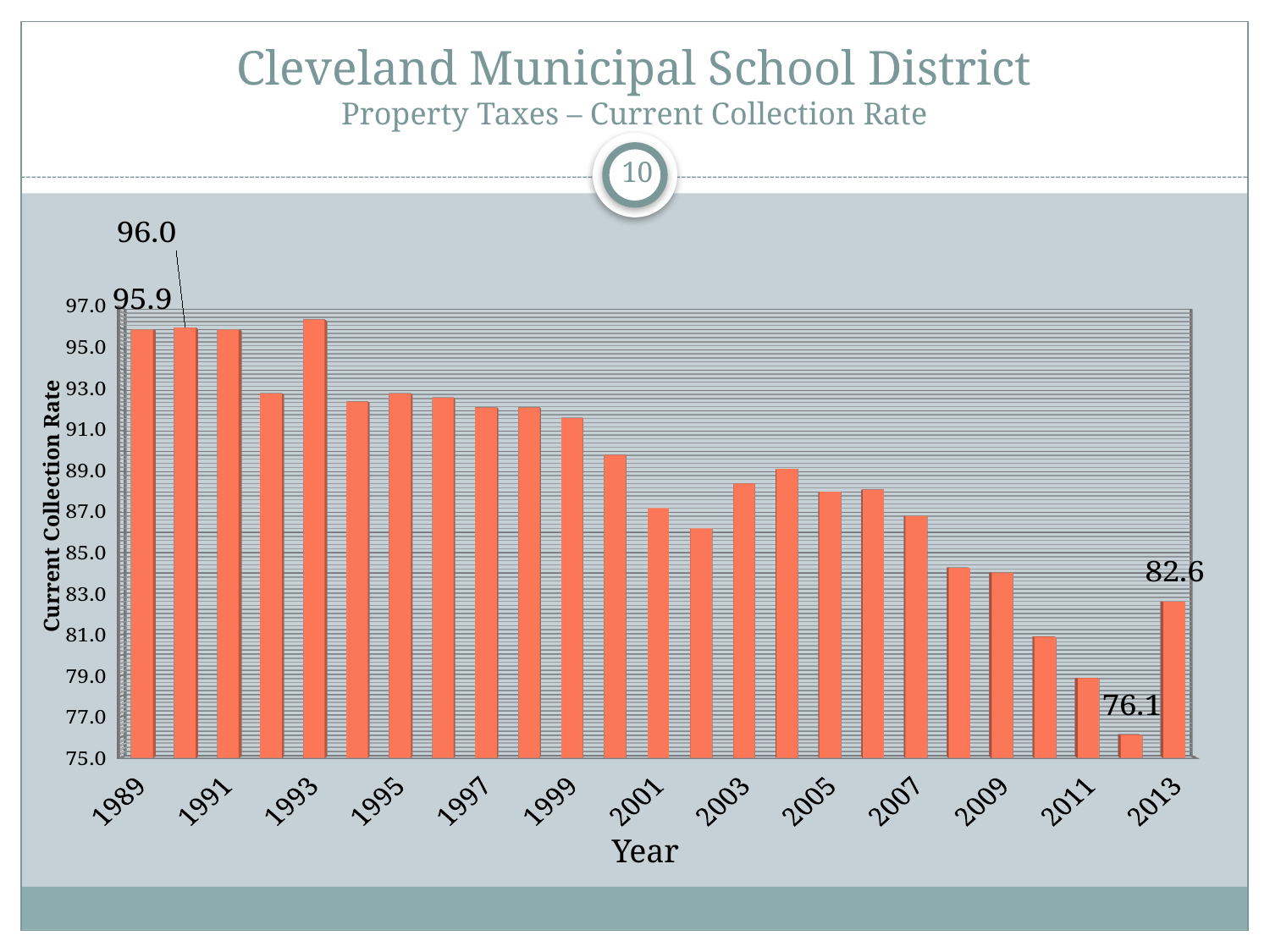
How many years are plotted on the chart? 25 Which year has the higher collection rate, 2012 or 2013? 2013 What is the difference between the collection rates for 2013 and 2012? 6.5 Is the value for 2001 greater or less than 89.0? less What type of chart is shown on the slide? bar chart What is the label on the vertical axis of the chart? Current Collection Rate Is the value for 2011 greater or less than 81.0? less What is the current collection rate for 2013? 82.6 What is the current collection rate for 1989? 95.9 What is the current collection rate for 2012? 76.1 Do the collection rates generally rise or fall from 1989 to 2012? fall Which year has the lowest current collection rate? 2012